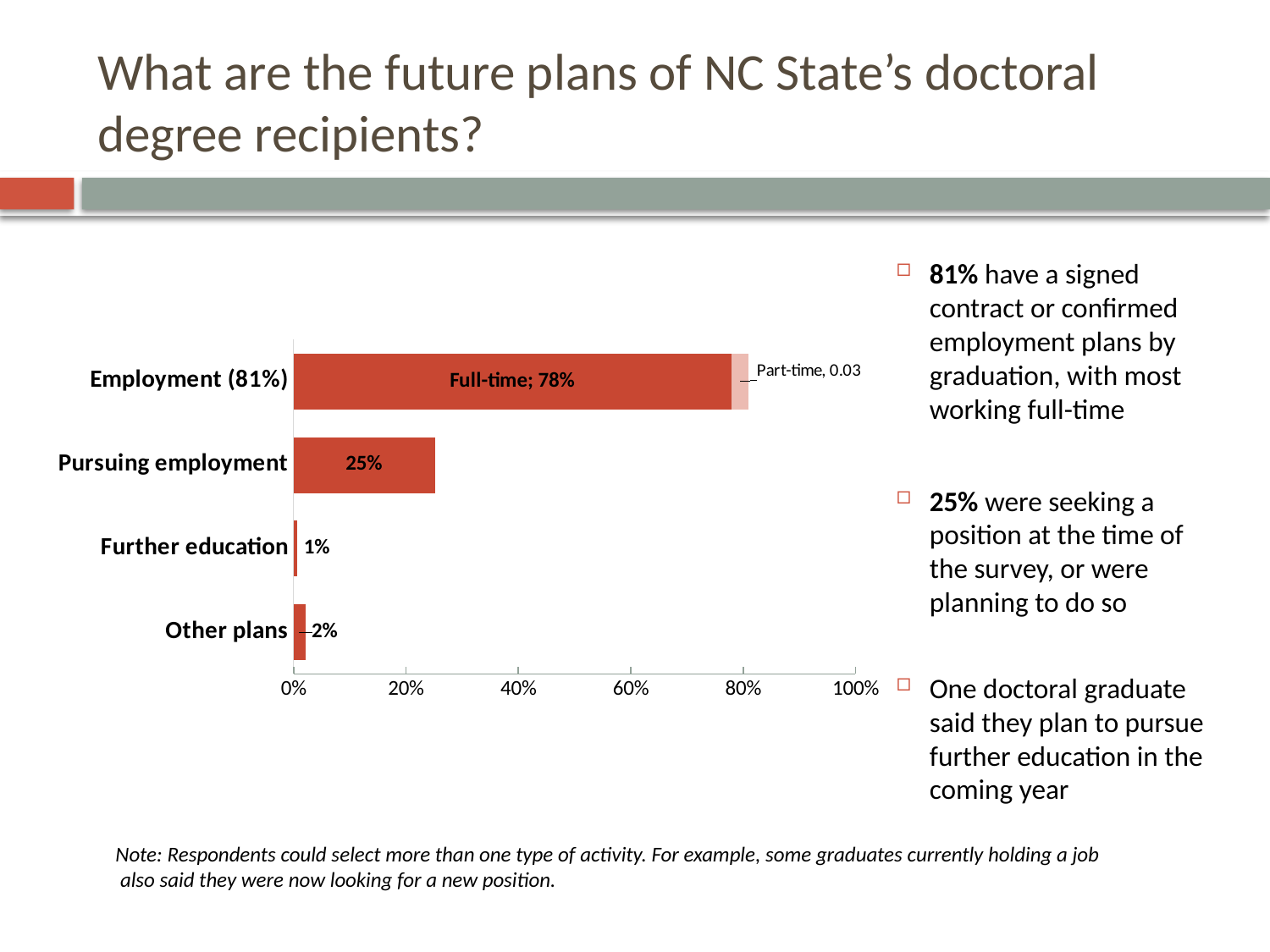
Which is larger, the value for Pursuing employment or the value for Other plans? Pursuing employment What kind of chart is shown on the slide? bar chart What is the difference between the Pursuing employment value and the Other plans value? 23% What is the value for Pursuing employment? 25% Is the value for Pursuing employment greater or less than 40%? less What is the value labelled for Full-time within the Employment bar? 78% What is the value labelled for Part-time within the Employment bar? 0.03 What is the value for Further education? 1% What is the value for Other plans? 2% How many categories are plotted on the chart? 4 Which category has the longest bar? Employment (81%) Which category has the shortest bar? Further education